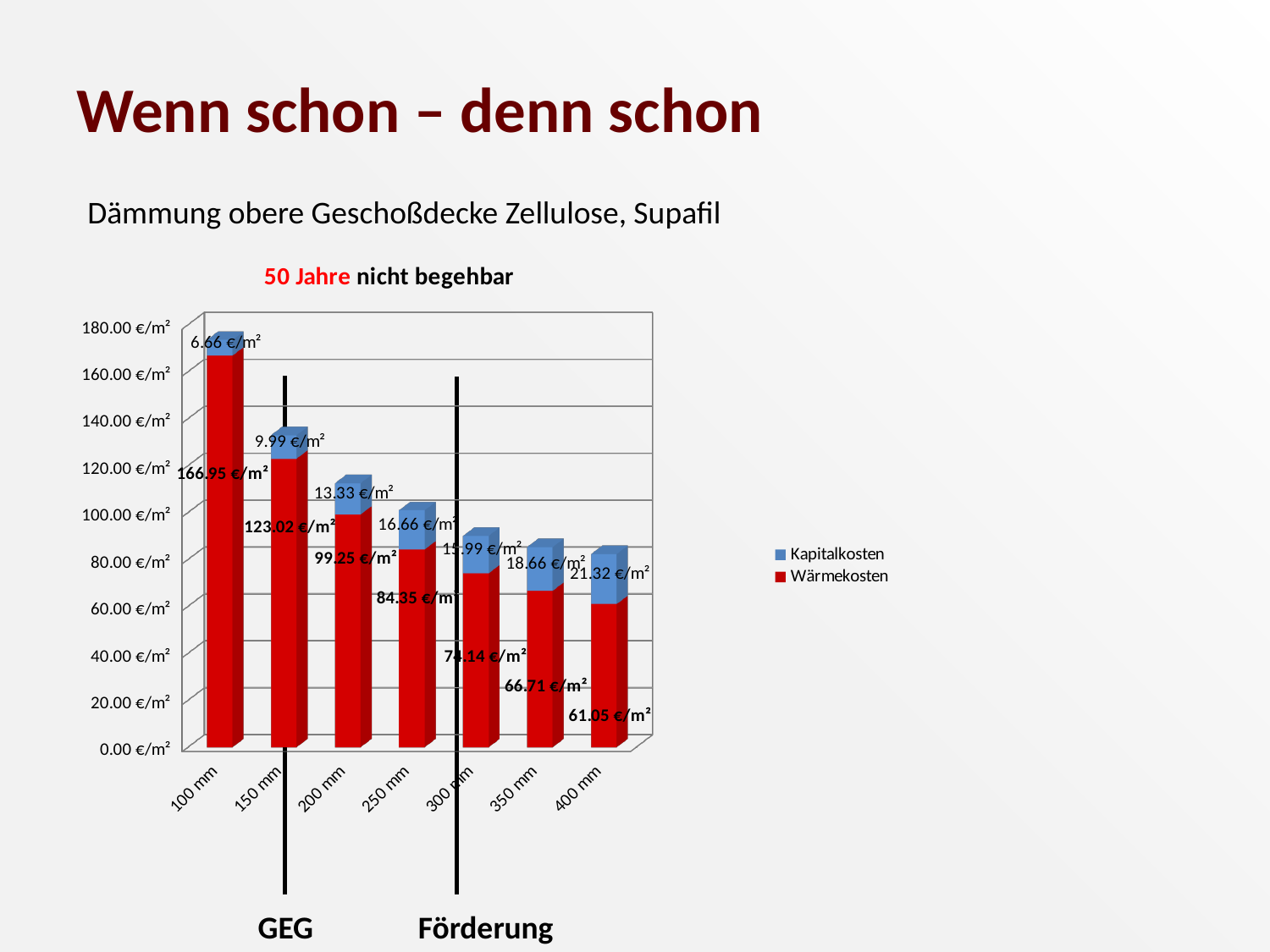
What is the Kapitalkosten value for 400 mm? 21.32 €/m² What is the total of the stacked bar for 400 mm? 82.37 €/m² What kind of chart is shown on the slide? Stacked bar chart How many series does the legend list? 2 Which category has the lowest Kapitalkosten? 100 mm What is the difference in Wärmekosten between 100 mm and 400 mm? 105.90 €/m² Which category has the highest Wärmekosten? 100 mm Which is larger, the Wärmekosten for 150 mm or for 200 mm? 150 mm What is the Wärmekosten value for 100 mm? 166.95 €/m² How many insulation thickness categories are shown on the x axis? 7 Do the Wärmekosten values rise or fall as the insulation thickness increases along the x axis? Fall What is the Wärmekosten value for 250 mm? 84.35 €/m²